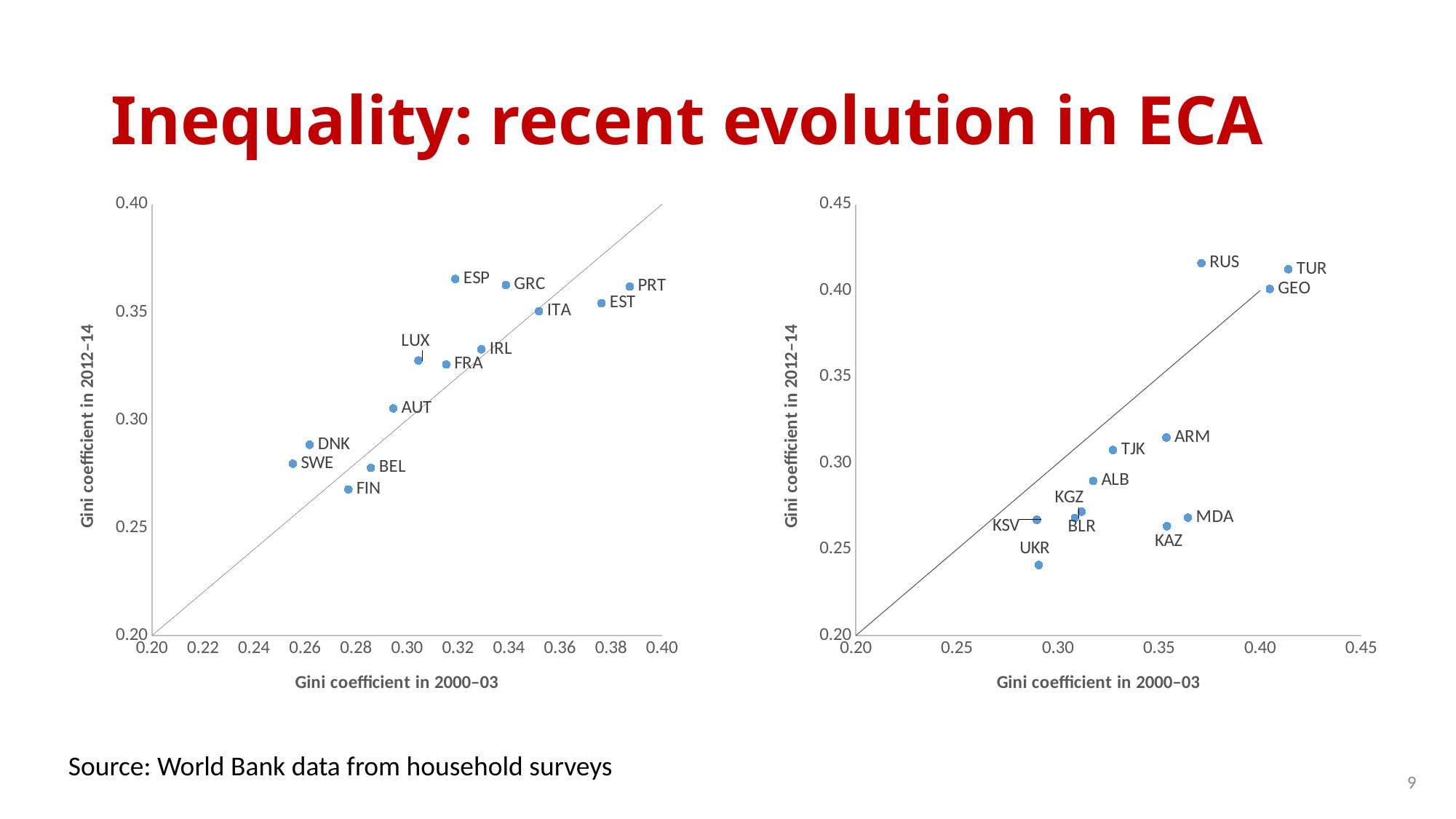
On the right chart, which country has the highest Gini coefficient in 2000–03? TUR On the left chart, is the Gini coefficient in 2000–03 for DNK greater or less than 0.28? less What kind of chart is the left chart on the slide? Scatter chart How many labelled country points are plotted on the left chart? 13 On the right chart, which has the larger Gini coefficient in 2012–14, RUS or UKR? RUS On the right chart, is the Gini coefficient in 2012–14 for UKR greater or less than 0.25? less On the left chart, is the Gini coefficient in 2012–14 for ESP greater or less than 0.35? greater On the left chart, which country has the lowest Gini coefficient in 2012–14? FIN What is the x-axis title of the right chart? Gini coefficient in 2000–03 On the right chart, which country has the lowest Gini coefficient in 2012–14? UKR How many labelled country points are plotted on the right chart? 12